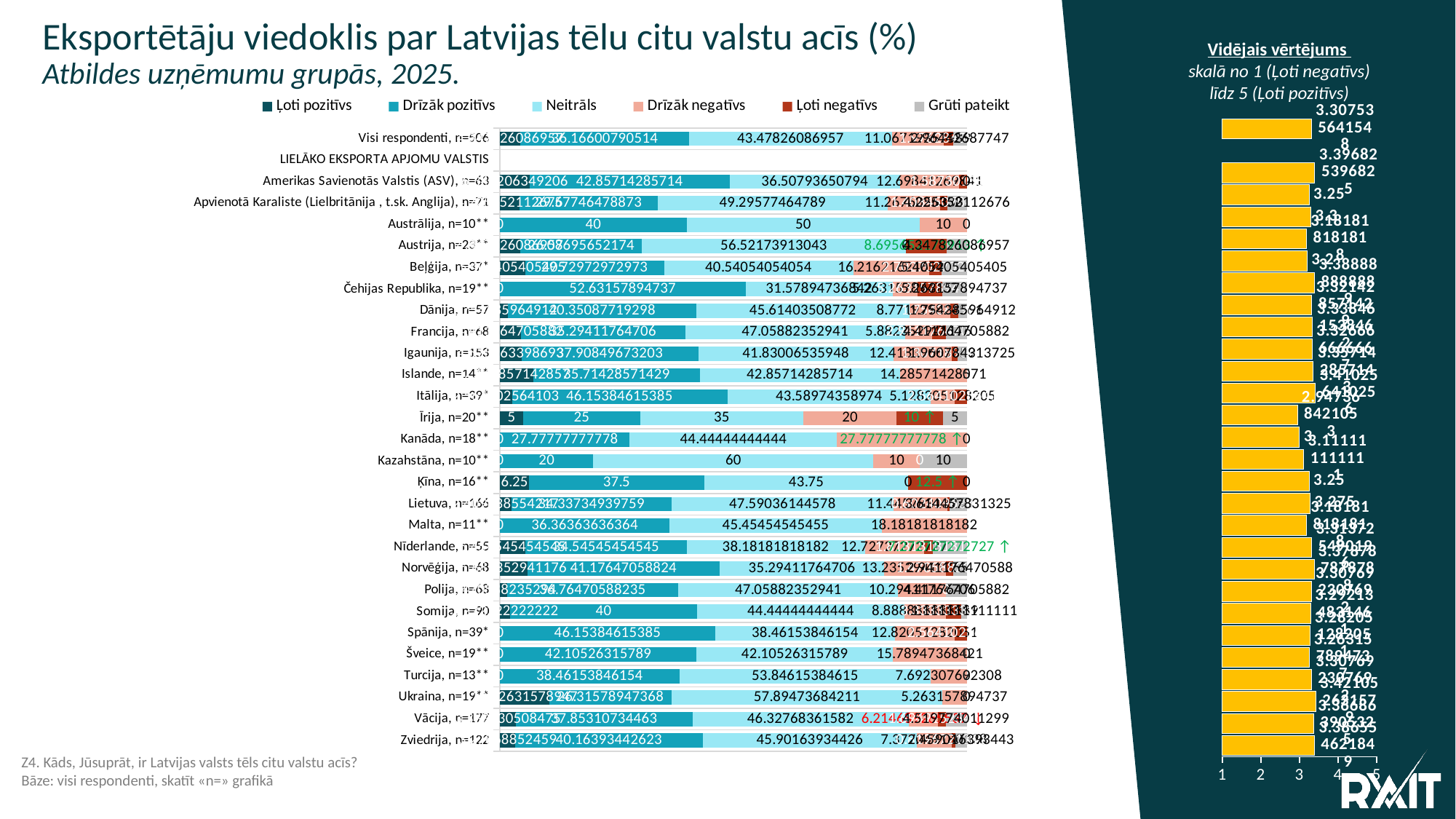
In the left chart, what is the Drīzāk pozitīvs value for Čehijas Republika, n=19**? 52.63157894737 In the left chart, what is the Neitrāls value for Kanāda, n=18**? 44.44444444444 In the left chart, for Kanāda, n=18**, which is larger: the Neitrāls value or the Drīzāk pozitīvs value? Neitrāls In the left chart, what is the Drīzāk pozitīvs value for Kazahstāna, n=10**? 20 In the left chart, what is the Drīzāk negatīvs value for Īrija, n=20**? 20 How many series does the legend of the left chart list? 6 What is the title of the chart on the right side of the slide? Vidējais vērtējums In the left chart, what is the Neitrāls value for Austrālija, n=10**? 50 In the left chart, which country has the highest Neitrāls value? Kazahstāna, n=10** In the left chart, what is the difference between the Neitrāls and Drīzāk pozitīvs values for Kazahstāna, n=10**? 40 What kind of chart is the main chart on the left of the slide? Stacked bar chart In the left chart, what is the Neitrāls value for Visi respondenti, n=506? 43.47826086957